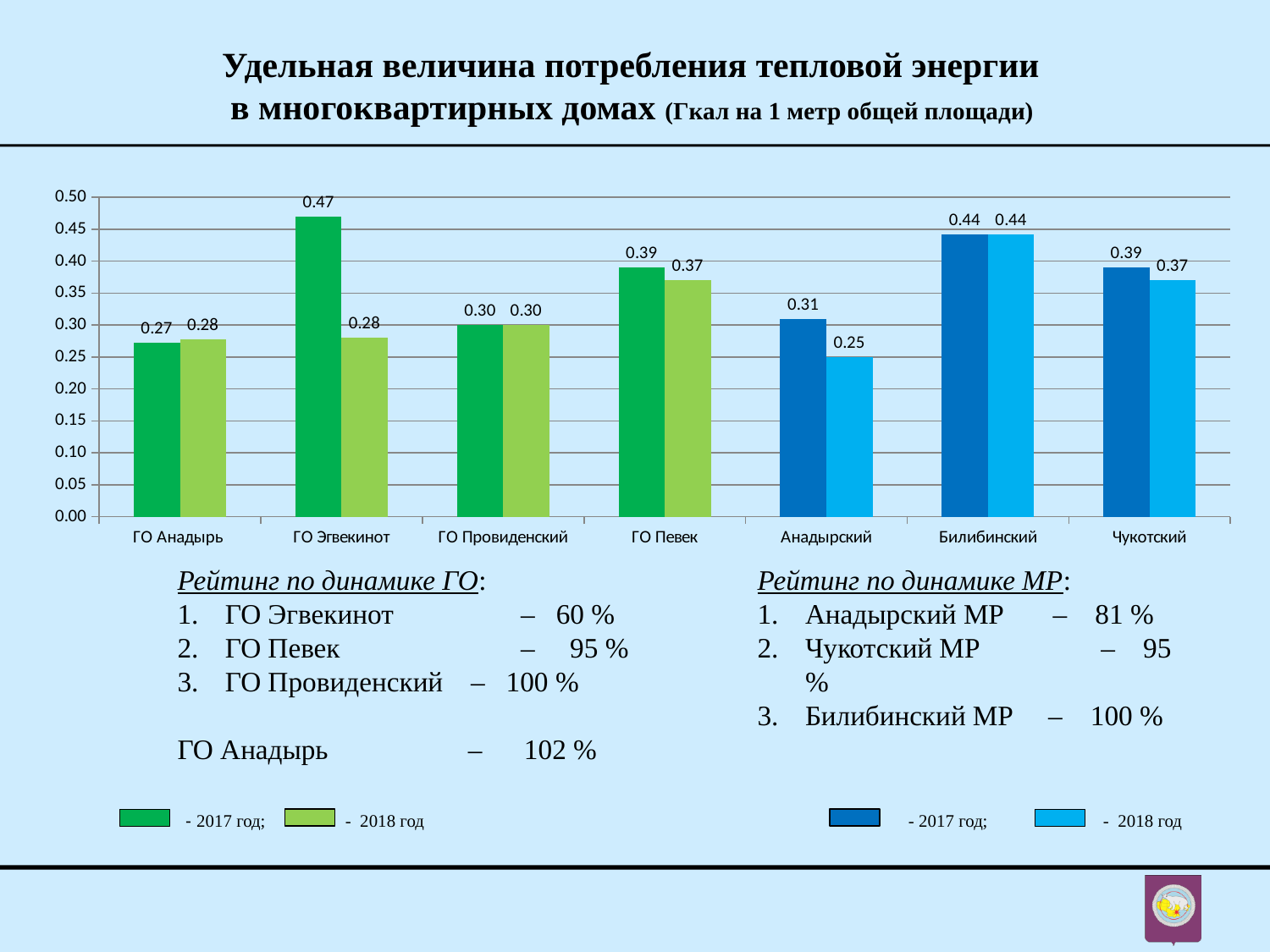
What kind of chart is shown on the slide? bar chart What is the 2017 value for ГО Эгвекинот? 0.47 What is the 2018 value for ГО Певек? 0.37 Which colour represents 2017 for the ГО categories in the legend? dark green Which category has the highest 2017 value? ГО Эгвекинот What is the difference between the 2017 and 2018 values for ГО Эгвекинот? 0.19 Which category has the lowest 2018 value? Анадырский What is the 2018 value for Анадырский? 0.25 Is the 2017 value for ГО Анадырь greater or less than 0.30? less Which is larger, the 2017 value for Билибинский or the 2017 value for Чукотский? Билибинский How many categories are shown on the x axis? 7 What is the difference between the 2017 and 2018 values for Анадырский? 0.06